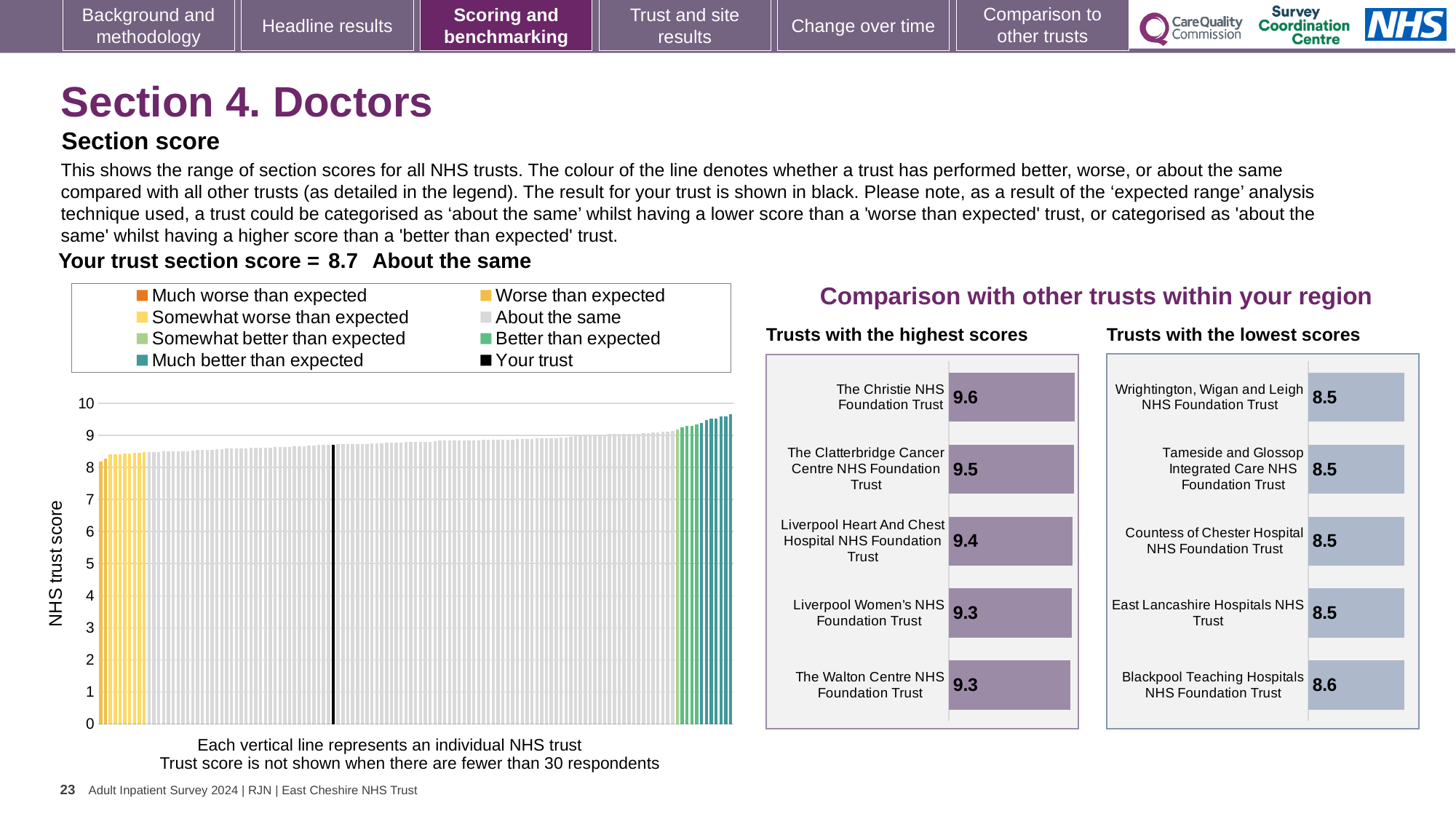
In the 'Trusts with the lowest scores' chart, which has the larger score: Blackpool Teaching Hospitals NHS Foundation Trust or East Lancashire Hospitals NHS Trust? Blackpool Teaching Hospitals NHS Foundation Trust How many trusts are shown in the 'Trusts with the highest scores' chart? 5 In the 'Trusts with the highest scores' chart, which trust has the highest score? The Christie NHS Foundation Trust How many entries does the legend of the large chart on the left list? 8 In the 'Trusts with the highest scores' chart, what is the difference between the scores of The Christie NHS Foundation Trust and The Walton Centre NHS Foundation Trust? 0.3 In the 'Trusts with the lowest scores' chart, which trust has the highest score? Blackpool Teaching Hospitals NHS Foundation Trust What kind of chart is the large chart on the left showing NHS trust scores? Bar chart In the 'Trusts with the highest scores' chart, what is the score for Liverpool Heart And Chest Hospital NHS Foundation Trust? 9.4 In the 'Trusts with the lowest scores' chart, what is the score for Blackpool Teaching Hospitals NHS Foundation Trust? 8.6 In the 'Trusts with the lowest scores' chart, what is the score for Countess of Chester Hospital NHS Foundation Trust? 8.5 In the 'Trusts with the highest scores' chart, what is the score for The Christie NHS Foundation Trust? 9.6 In the large chart on the left, do the trust scores rise or fall from left to right? Rise